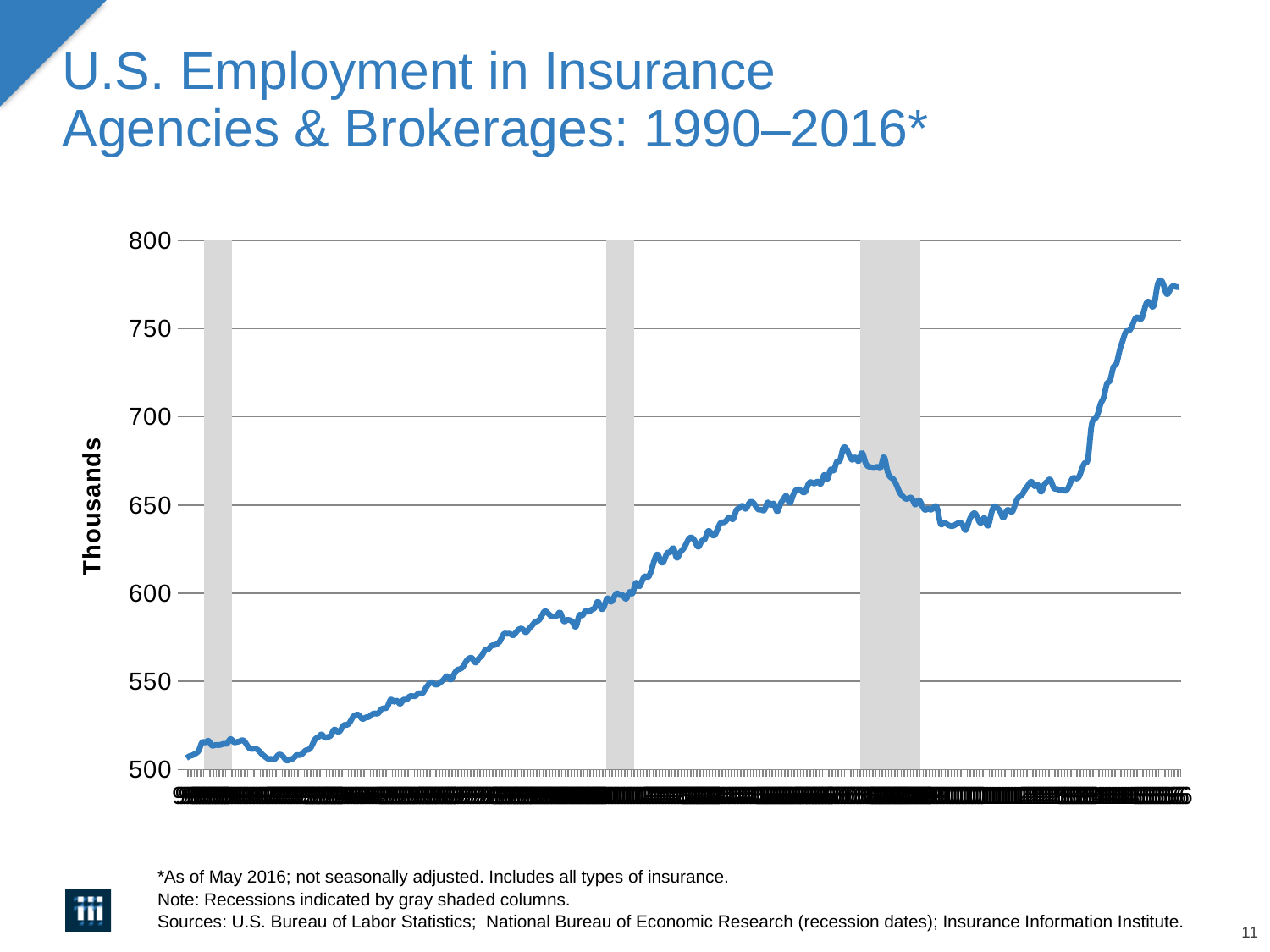
Is the peak reached just before the third gray shaded recession column greater or less than 700? less Is the value at the end of the series (May 2016) greater or less than 750? greater Overall, do the values rise or fall from the left of the chart to the right? rise Is the value at the start of the series (1990) greater or less than 550? less How many gray shaded recession columns are shown on the chart? 3 What is the label on the vertical axis? Thousands What kind of chart is shown on the slide? line chart Does the line rise or fall during the third gray shaded recession column? fall What is the highest value shown on the vertical axis? 800